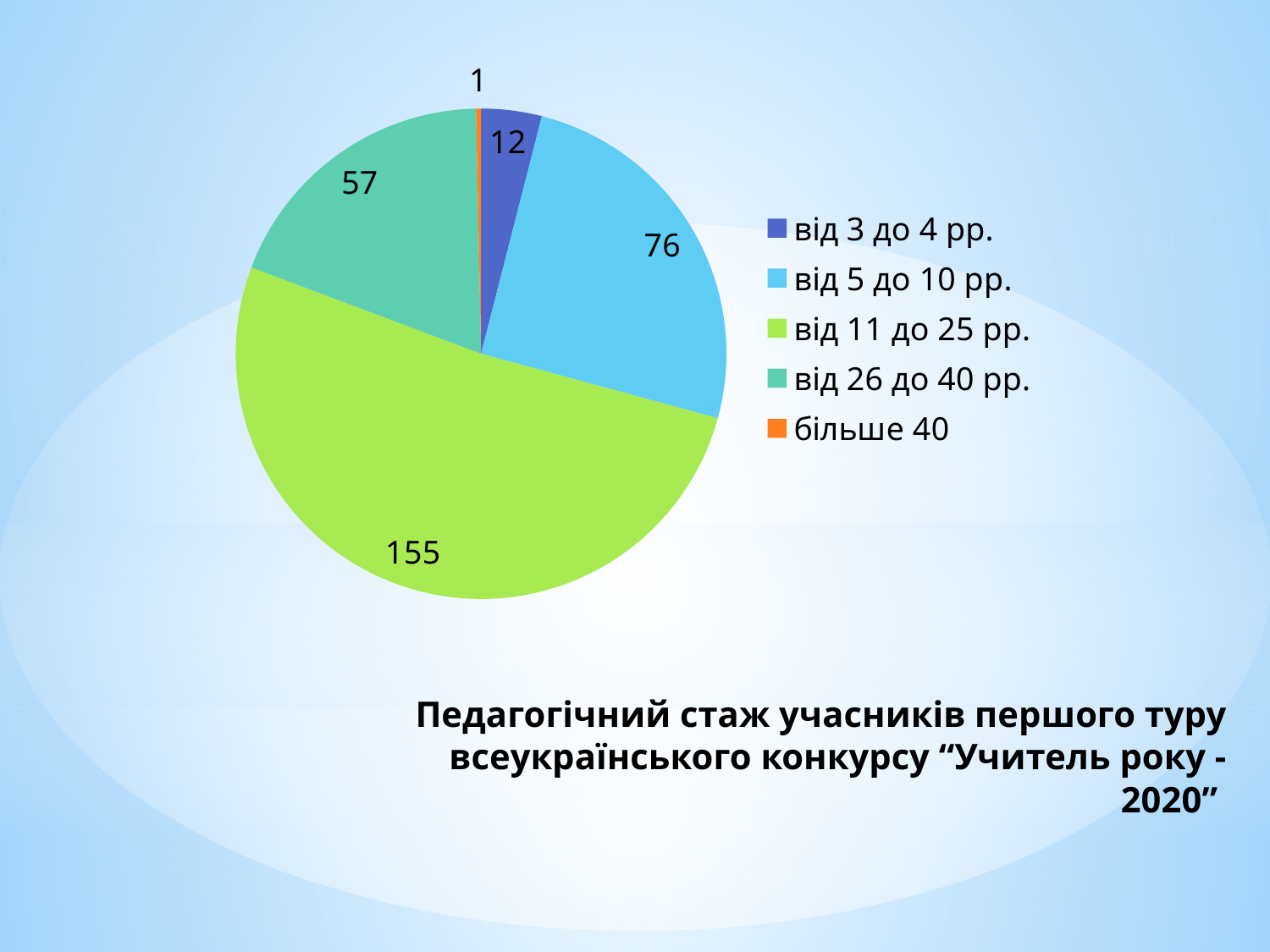
How many participants have teaching experience of від 11 до 25 рр.? 155 What is the value for the від 5 до 10 рр. slice? 76 What is the value for the більше 40 slice? 1 What is the value for the від 26 до 40 рр. slice? 57 What colour is the slice for від 11 до 25 рр.? green What is the difference between the від 11 до 25 рр. value and the від 5 до 10 рр. value? 79 Which category has the smallest slice of the pie? більше 40 Which category has the largest slice of the pie? від 11 до 25 рр. What is the total of all the slices in the pie chart? 301 Which is larger: the від 26 до 40 рр. slice or the від 3 до 4 рр. slice? від 26 до 40 рр. How many categories does the pie chart have? 5 What type of chart is shown on the slide? pie chart